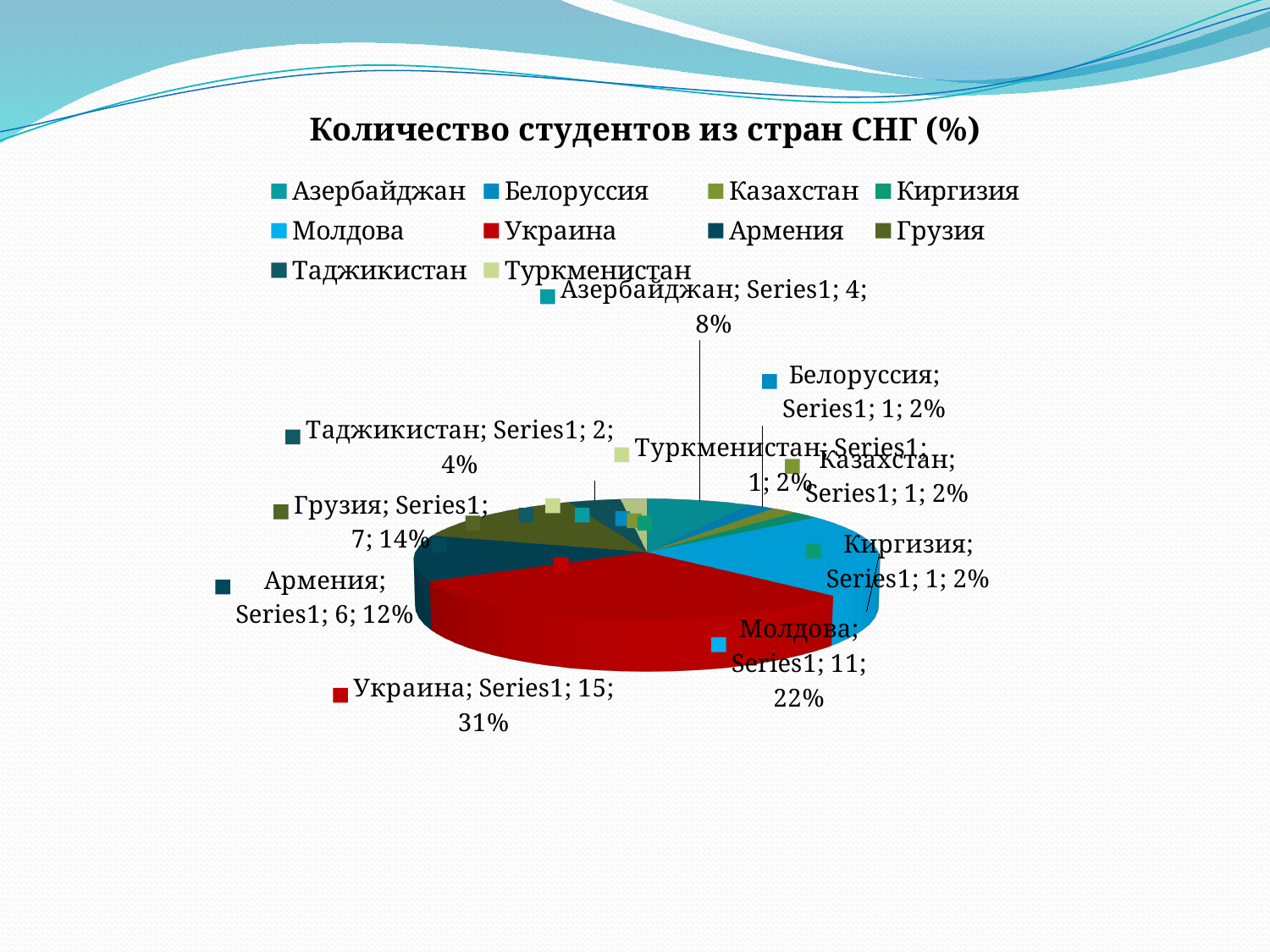
What is the value shown for Молдова? 11 What is the title of the chart? Количество студентов из стран СНГ (%) What percentage is shown for Грузия? 14% What is the difference between the values for Украина and Молдова? 4 What kind of chart is shown on the slide? pie chart What percentage is shown for Азербайджан? 8% What is the value shown for Армения? 6 How many countries (slices) does the pie chart show? 10 Which country has the largest slice of the pie? Украина Which is larger, the value for Грузия or the value for Армения? Грузия What is the value shown for Таджикистан? 2 What share of the pie does Украина account for? 31%